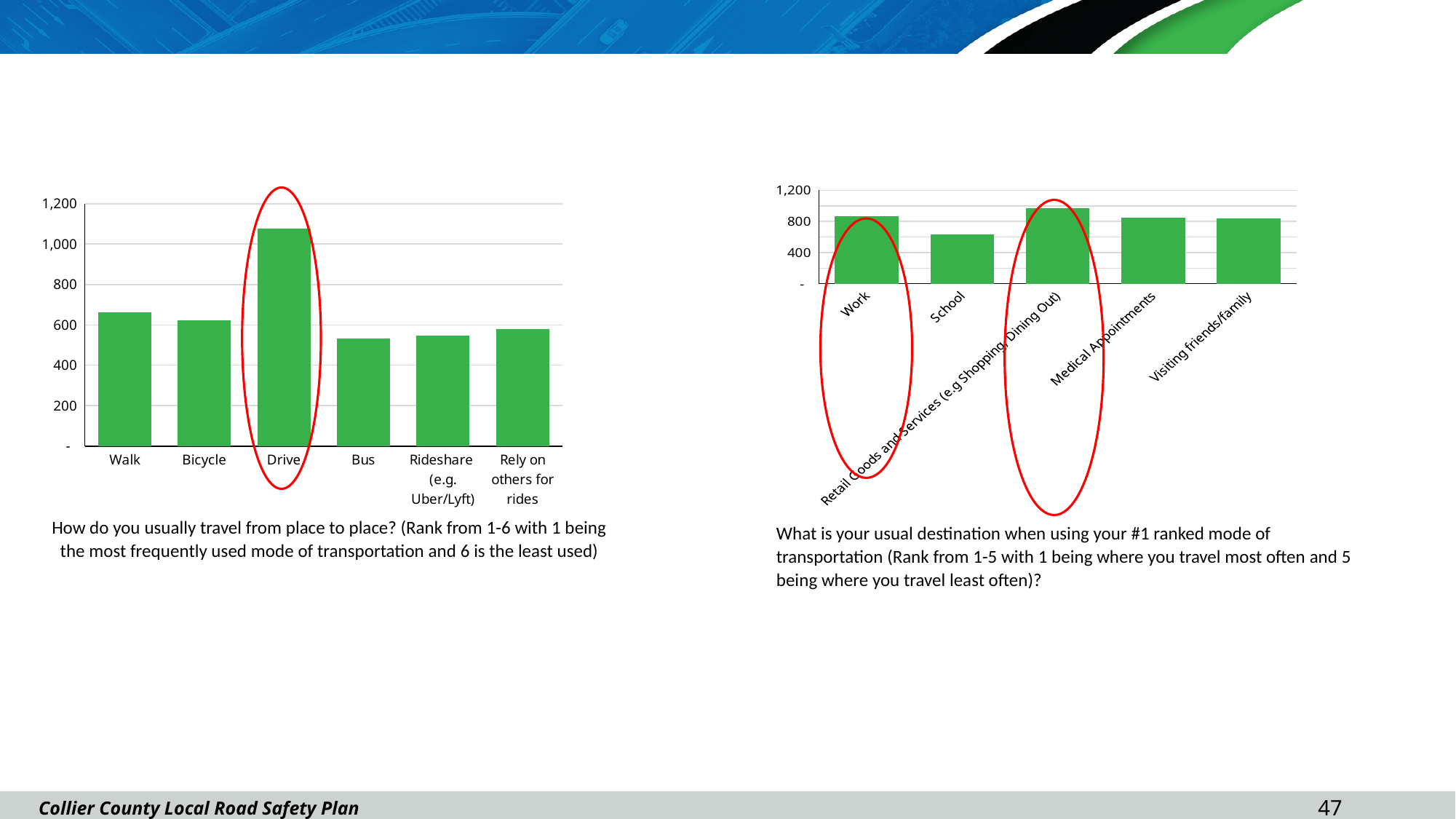
On the right chart (What is your usual destination when using your #1 ranked mode of transportation?), which destination has the lowest value? School How many categories are shown on the right chart (What is your usual destination when using your #1 ranked mode of transportation?)? 5 How many categories are shown on the left chart (How do you usually travel from place to place?)? 6 On the right chart (What is your usual destination when using your #1 ranked mode of transportation?), which destination has the highest value? Retail Goods and Services (e.g Shopping, Dining Out) On the left chart (How do you usually travel from place to place?), is the value for Walk greater or less than 600? greater On the left chart (How do you usually travel from place to place?), is the value for Bus greater or less than 600? less On the left chart (How do you usually travel from place to place?), is the value for Drive greater or less than 1,000? greater On the left chart (How do you usually travel from place to place?), which mode of transportation has the highest value? Drive On the left chart (How do you usually travel from place to place?), which is larger, the value for Walk or the value for Bus? Walk On the right chart (What is your usual destination when using your #1 ranked mode of transportation?), which is larger, the value for Work or the value for School? Work What kind of chart is the left chart (How do you usually travel from place to place?)? bar chart